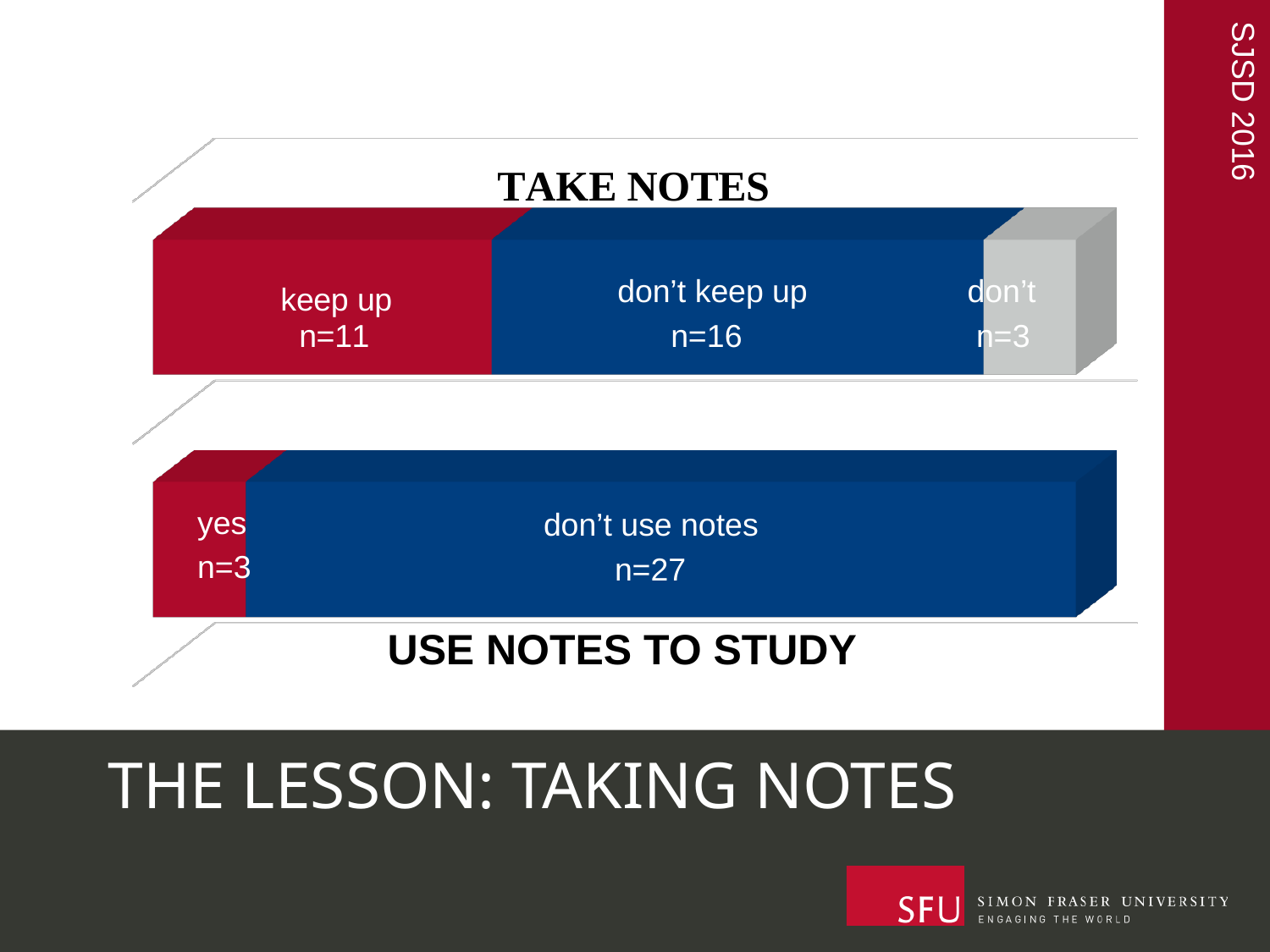
In the TAKE NOTES chart, which segment has the largest value? don't keep up In the USE NOTES TO STUDY chart, what is the value for 'yes'? n=3 In the TAKE NOTES chart, what is the difference between 'don't keep up' and 'keep up'? 5 What is the total of all segments in the TAKE NOTES bar? 30 How many segments does the TAKE NOTES bar have? 3 In the USE NOTES TO STUDY chart, what is the difference between 'don't use notes' and 'yes'? 24 In the TAKE NOTES chart, what is the value for the 'keep up' segment? n=11 In the USE NOTES TO STUDY chart, what is the value for 'don't use notes'? n=27 In the TAKE NOTES chart, what is the value for the 'don't keep up' segment? n=16 In the TAKE NOTES chart, which segment has the smallest value? don't In the TAKE NOTES chart, what is the value for the 'don't' segment? n=3 What kind of chart is used on this slide? stacked bar chart